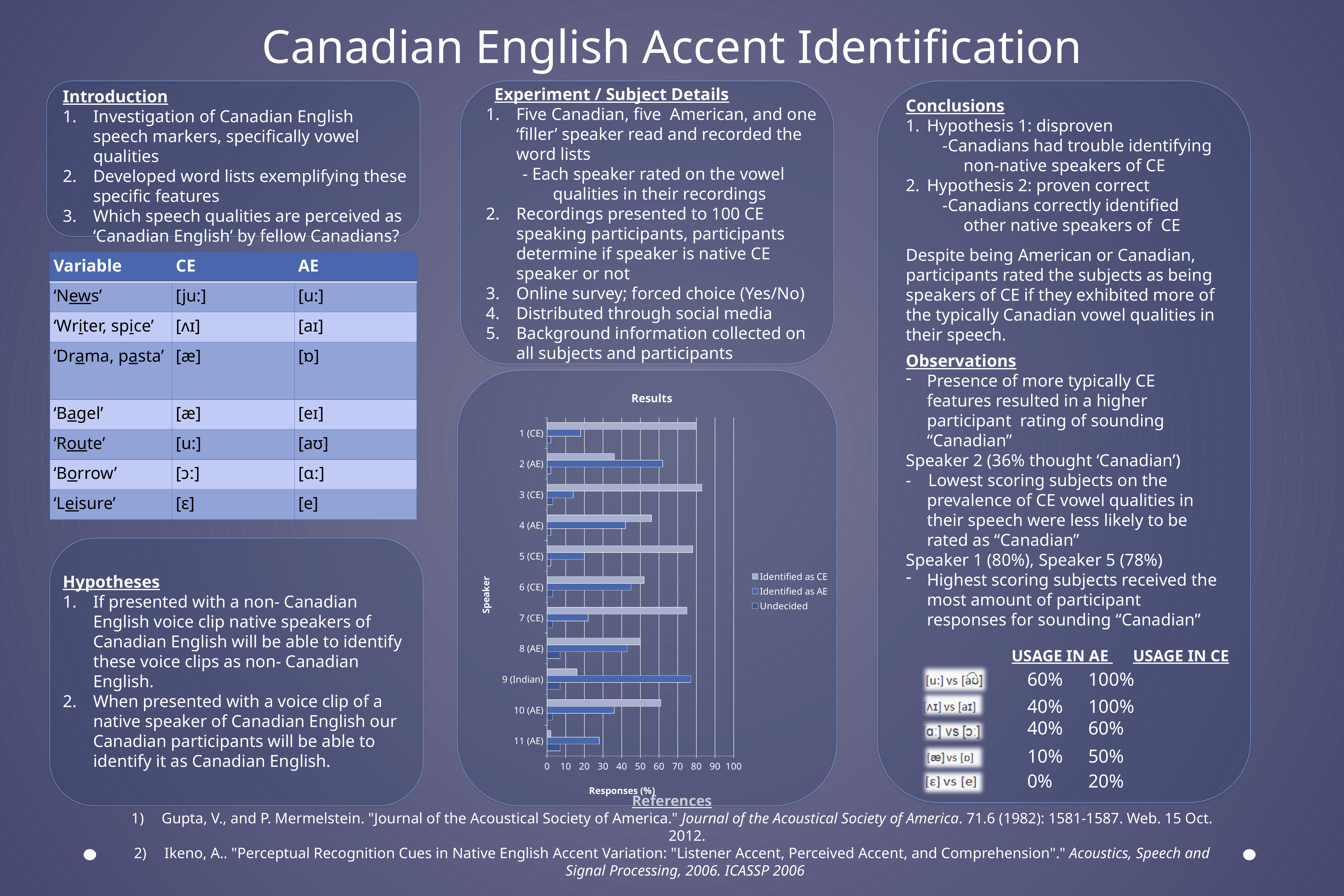
What kind of chart is the "Results" chart? bar chart In the "Results" chart, is the "Identified as CE" value for speaker 9 (Indian) greater or less than 30? less What is the label of the horizontal axis of the "Results" chart? Responses (%) In the "Results" chart, for speaker 7 (CE), which is larger: "Identified as CE" or "Identified as AE"? Identified as CE In the "Results" chart, which speaker has the lowest "Identified as CE" value? 11 (AE) In the "Results" chart, for speaker 2 (AE), which is larger: "Identified as CE" or "Identified as AE"? Identified as AE In the "Results" chart, is the "Identified as AE" value for speaker 11 (AE) greater or less than 40? less In the "Results" chart, which speaker has the highest "Identified as AE" value? 9 (Indian) How many series does the legend of the "Results" chart list? 3 In the "Results" chart, is the "Identified as CE" value for speaker 1 (CE) greater or less than 70? greater How many speakers are shown on the y axis of the "Results" chart? 11 In the "Results" chart, which speaker has the larger "Identified as AE" value: 9 (Indian) or 11 (AE)? 9 (Indian)